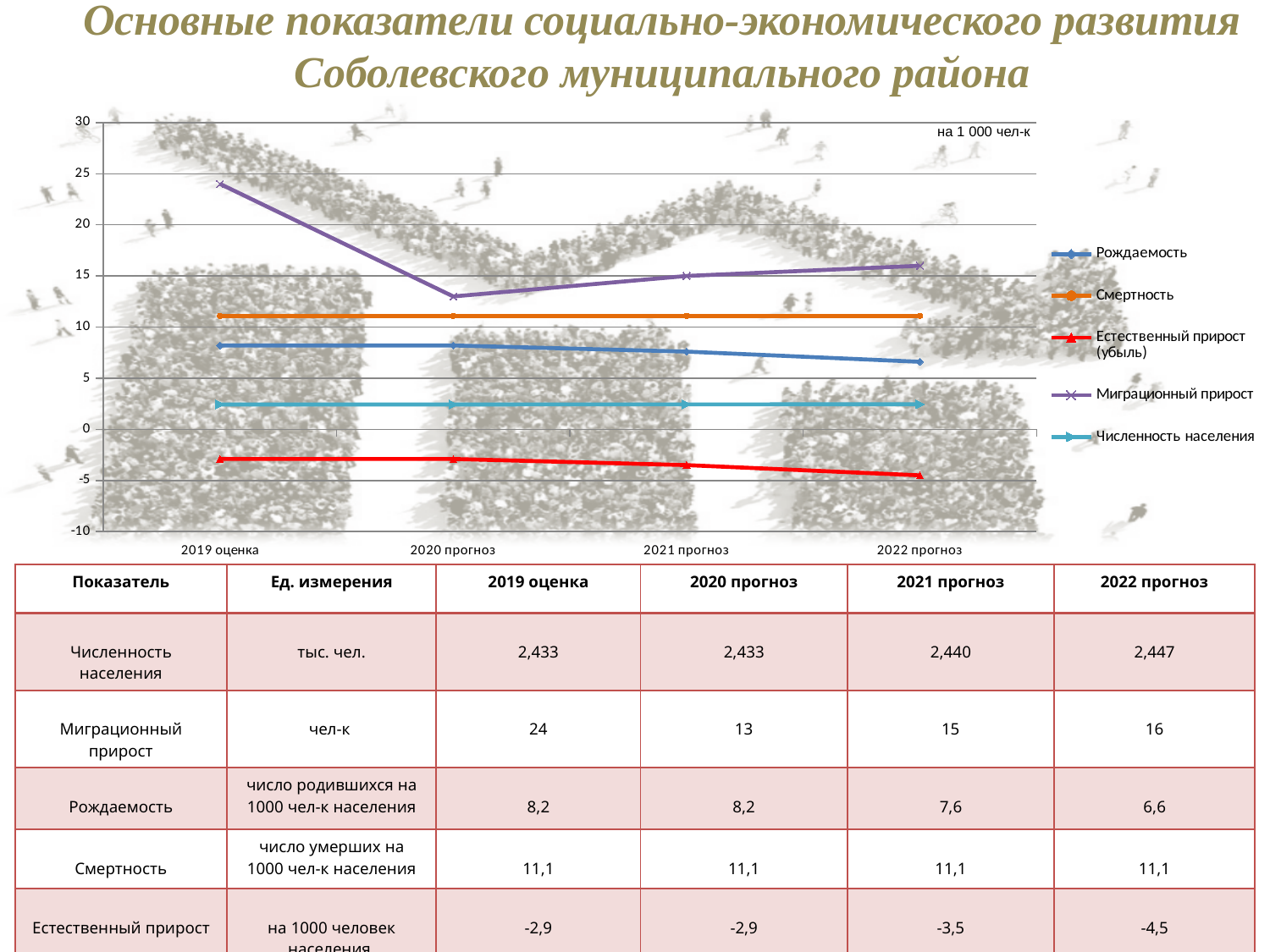
How many series does the chart legend list? 5 In which period is Миграционный прирост highest? 2019 оценка What is the value of Естественный прирост for 2022 прогноз? -4,5 In which period is Миграционный прирост lowest? 2020 прогноз What is the value of Рождаемость for 2022 прогноз? 6,6 What is the value of Миграционный прирост for 2019 оценка? 24 What type of chart is shown on the slide? line chart How many periods are shown along the x axis of the chart? 4 Is the value for Миграционный прирост in 2019 оценка greater or less than 20? greater Which is larger in 2019 оценка, Смертность or Рождаемость? Смертность What is the difference between Миграционный прирост in 2019 оценка and 2020 прогноз? 11 Does Рождаемость rise or fall from 2019 оценка to 2022 прогноз? falls